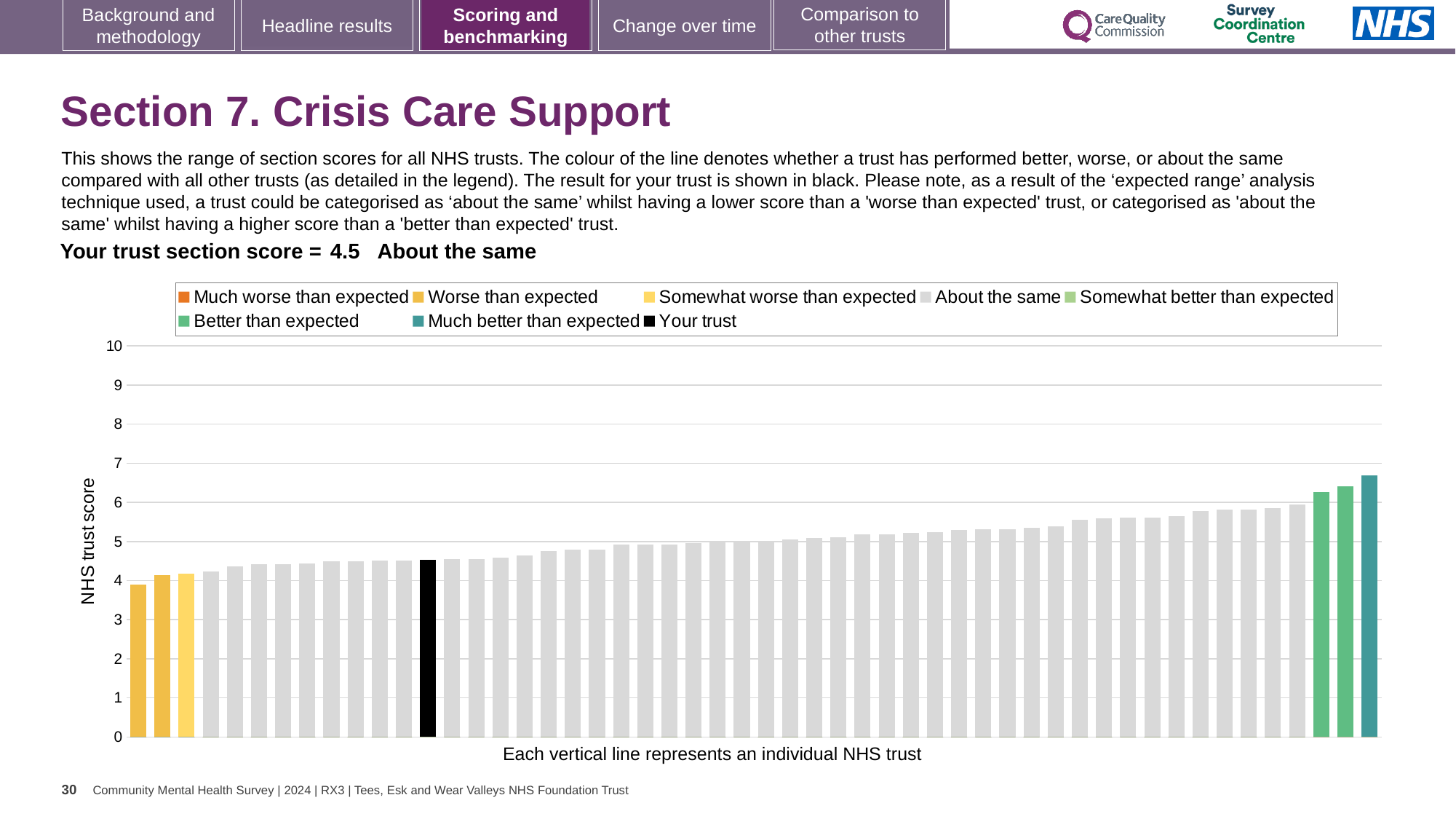
Is the value of the lowest bar (the leftmost bar) greater or less than 4? less Do the bar values rise or fall from left to right along the x axis? rise Is the value of the highest bar (the rightmost, teal bar) greater or less than 6? greater How many bars are coloured as 'Much better than expected' (teal)? 1 Which is higher, the leftmost bar or the rightmost bar? the rightmost bar What is the label on the y axis of the chart? NHS trust score Is the value for your trust (the black bar) greater or less than 5? less Which category is your trust placed in for this section? About the same How many entries does the chart legend list? 8 What kind of chart is shown on the slide? bar chart What is the section score for your trust shown on the slide? 4.5